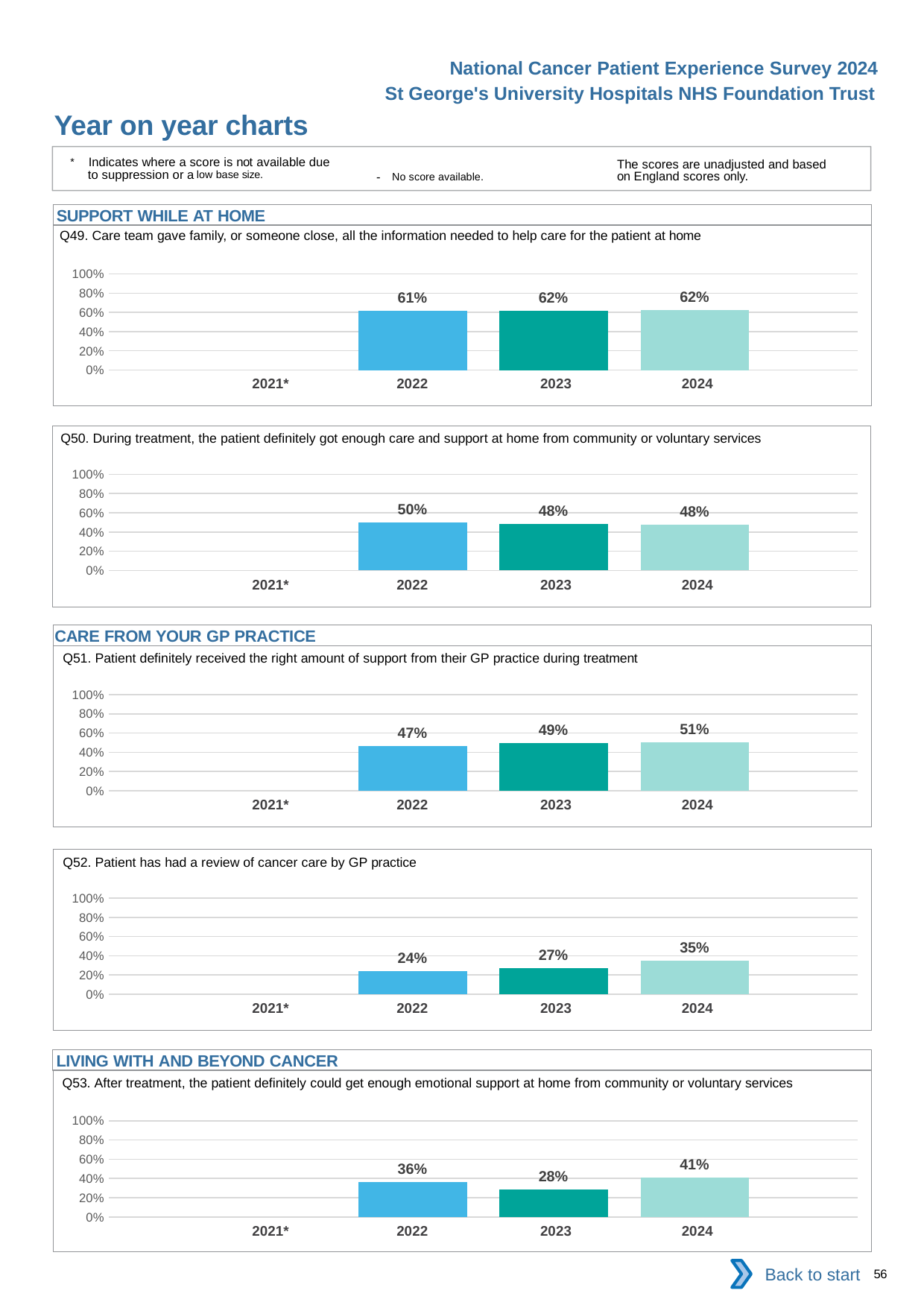
In the Q51 chart, how many years are shown on the x axis? 4 In the Q53 chart, is the value for 2024 greater or less than 60%? less In the Q49 chart, what is the value for 2022? 61% In the Q51 chart, do the values rise or fall from 2022 to 2024? rise In the Q53 chart, what is the value for 2024? 41% In the Q50 chart, what is the value for 2023? 48% Which year on the x axis of the Q49 chart is marked with an asterisk? 2021* In the Q51 chart, which year has the highest value? 2024 In the Q52 chart, what is the difference between the 2024 and 2022 values? 11% What kind of chart is the Q50 chart? bar chart In the Q52 chart, which year has the lowest value? 2022 In the Q53 chart, which is larger, the value for 2022 or the value for 2023? 2022